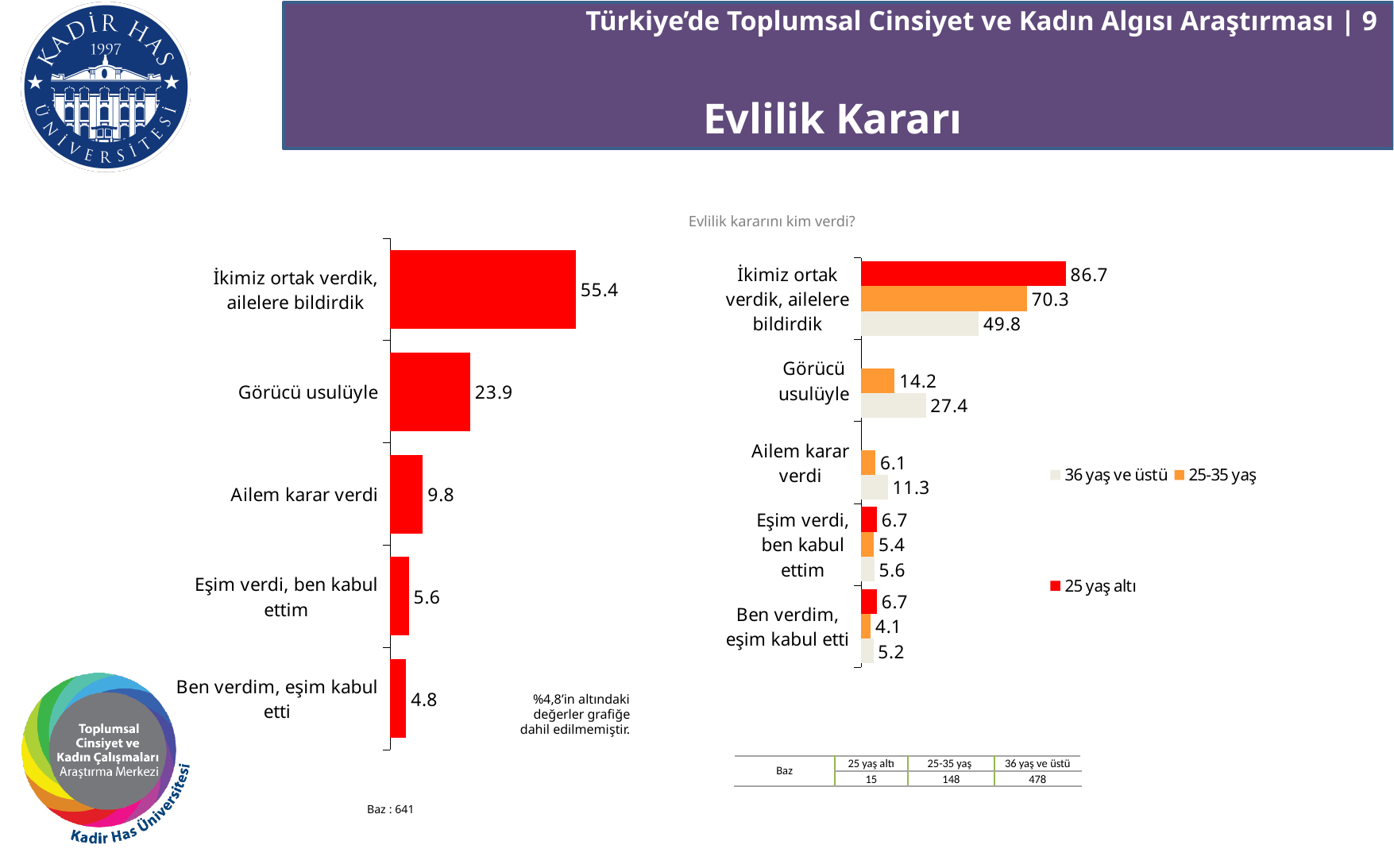
In the left chart, what is the value for 'Görücü usulüyle'? 23.9 In the right chart ('Evlilik kararını kim verdi?'), what is the value for '25-35 yaş' in 'Ben verdim, eşim kabul etti'? 4.1 In the right chart ('Evlilik kararını kim verdi?'), what is the value for '36 yaş ve üstü' in 'Görücü usulüyle'? 27.4 In the left chart, what is the difference between 'Görücü usulüyle' and 'Ailem karar verdi'? 14.1 How many categories does the left chart show? 5 In the left chart, what is the value for 'İkimiz ortak verdik, ailelere bildirdik'? 55.4 In the right chart ('Evlilik kararını kim verdi?'), how many series does the legend list? 3 What kind of chart is the left chart? Bar chart In the left chart, which category has the lowest value? Ben verdim, eşim kabul etti In the right chart ('Evlilik kararını kim verdi?'), which is larger for 'Ailem karar verdi': '25-35 yaş' or '36 yaş ve üstü'? 36 yaş ve üstü In the right chart ('Evlilik kararını kim verdi?'), what is the value for '25 yaş altı' in 'İkimiz ortak verdik, ailelere bildirdik'? 86.7 In the right chart ('Evlilik kararını kim verdi?'), what is the difference between '25 yaş altı' and '36 yaş ve üstü' for 'İkimiz ortak verdik, ailelere bildirdik'? 36.9